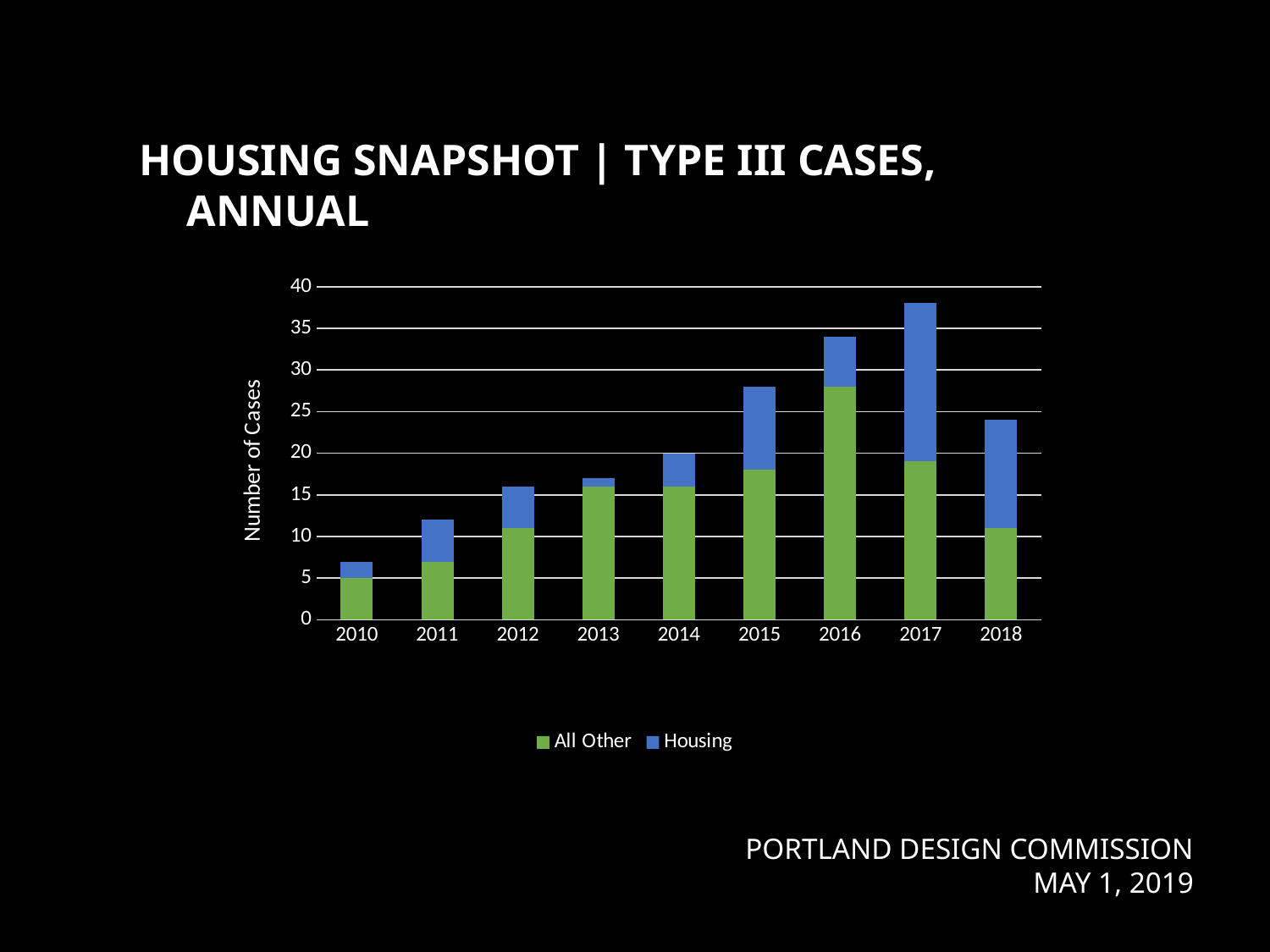
Which year has the tallest total bar? 2017 What kind of chart is shown on the slide? stacked bar chart Is the total number of cases in 2018 greater or less than 25? less How many series does the legend list? 2 How many years are shown on the x axis? 9 What is the label of the y axis? Number of Cases Do the total bars generally rise or fall from 2010 to 2017? rise Is the total number of cases in 2017 greater or less than 35? greater Which year has the shortest total bar? 2010 Is the All Other value for 2016 greater or less than 25? greater Which year has a larger total bar, 2015 or 2016? 2016